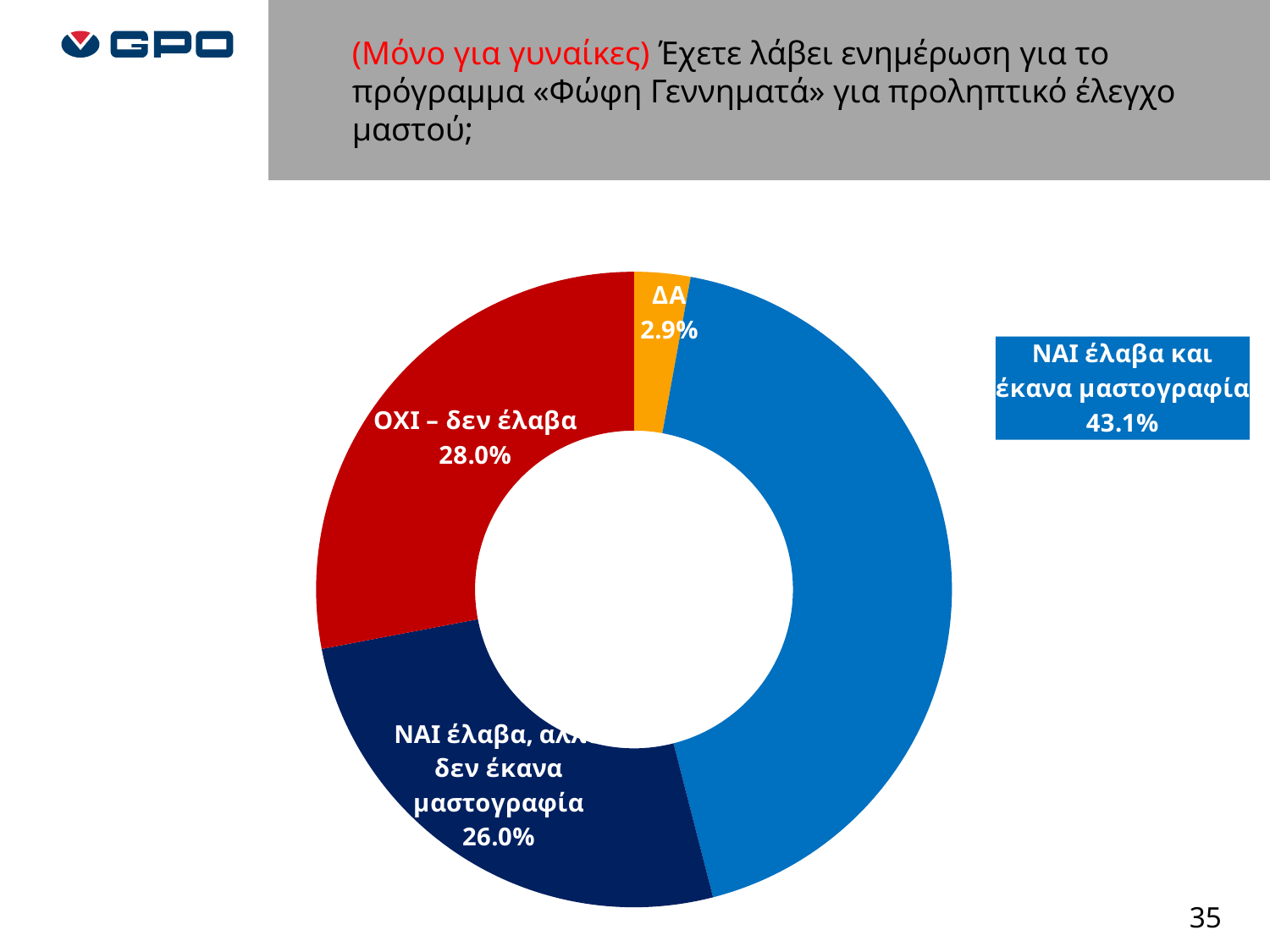
How many response categories are shown in the chart? 4 Which response has the smallest share of the pie? ΔΑ What kind of chart is shown on the slide? Pie chart (donut) What percentage of respondents answered "ΝΑΙ έλαβα και έκανα μαστογραφία"? 43.1% Which is larger: the share for "ΟΧΙ – δεν έλαβα" or the share for "ΝΑΙ έλαβα, αλλά δεν έκανα μαστογραφία"? ΟΧΙ – δεν έλαβα What colour is the slice for "ΟΧΙ – δεν έλαβα"? Red Which response has the largest share of the pie? ΝΑΙ έλαβα και έκανα μαστογραφία What percentage of respondents answered "ΟΧΙ – δεν έλαβα"? 28.0% What is the difference in percentage points between "ΝΑΙ έλαβα και έκανα μαστογραφία" and "ΟΧΙ – δεν έλαβα"? 15.1 percentage points What percentage of respondents answered "ΝΑΙ έλαβα, αλλά δεν έκανα μαστογραφία"? 26.0% What percentage of respondents answered "ΔΑ"? 2.9% What is the combined share of the two "ΝΑΙ έλαβα" responses? 69.1%